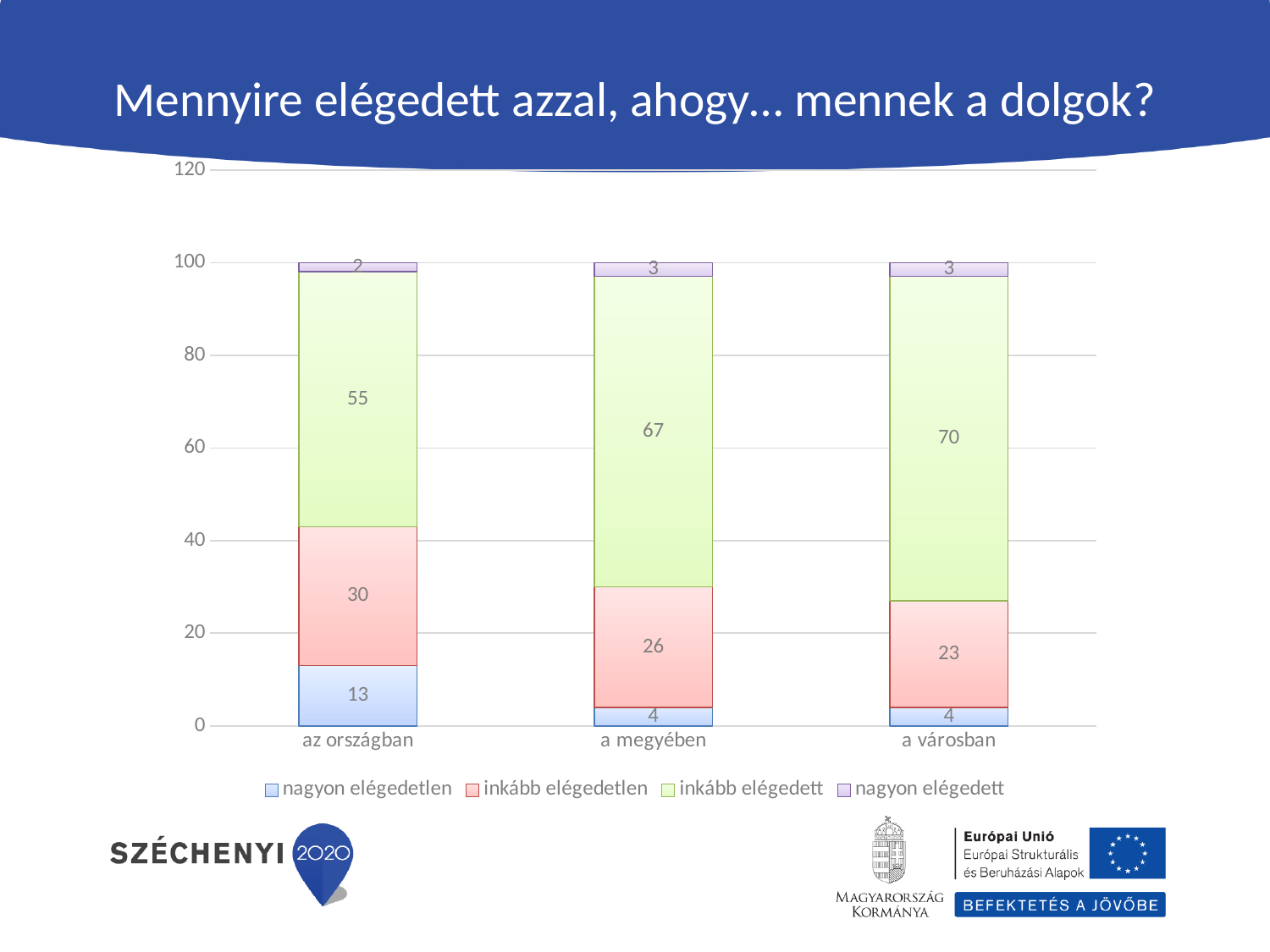
What is the difference between the "inkább elégedett" values for "a városban" and "az országban"? 15 What is the total of the stacked bar for "a megyében"? 100 What is the value for "inkább elégedetlen" in the "a városban" bar? 23 What is the value for "nagyon elégedetlen" in the "az országban" bar? 13 What is the value for "nagyon elégedett" in the "az országban" bar? 2 What kind of chart is shown on the slide? Stacked bar chart How many categories are shown on the x axis? 3 What is the value for "inkább elégedett" in the "a megyében" bar? 67 Which is larger: "inkább elégedetlen" for "az országban" or for "a megyében"? az országban Which category has the highest value for "inkább elégedett"? a városban How many series does the legend list? 4 Which category has the lowest value for "inkább elégedetlen"? a városban